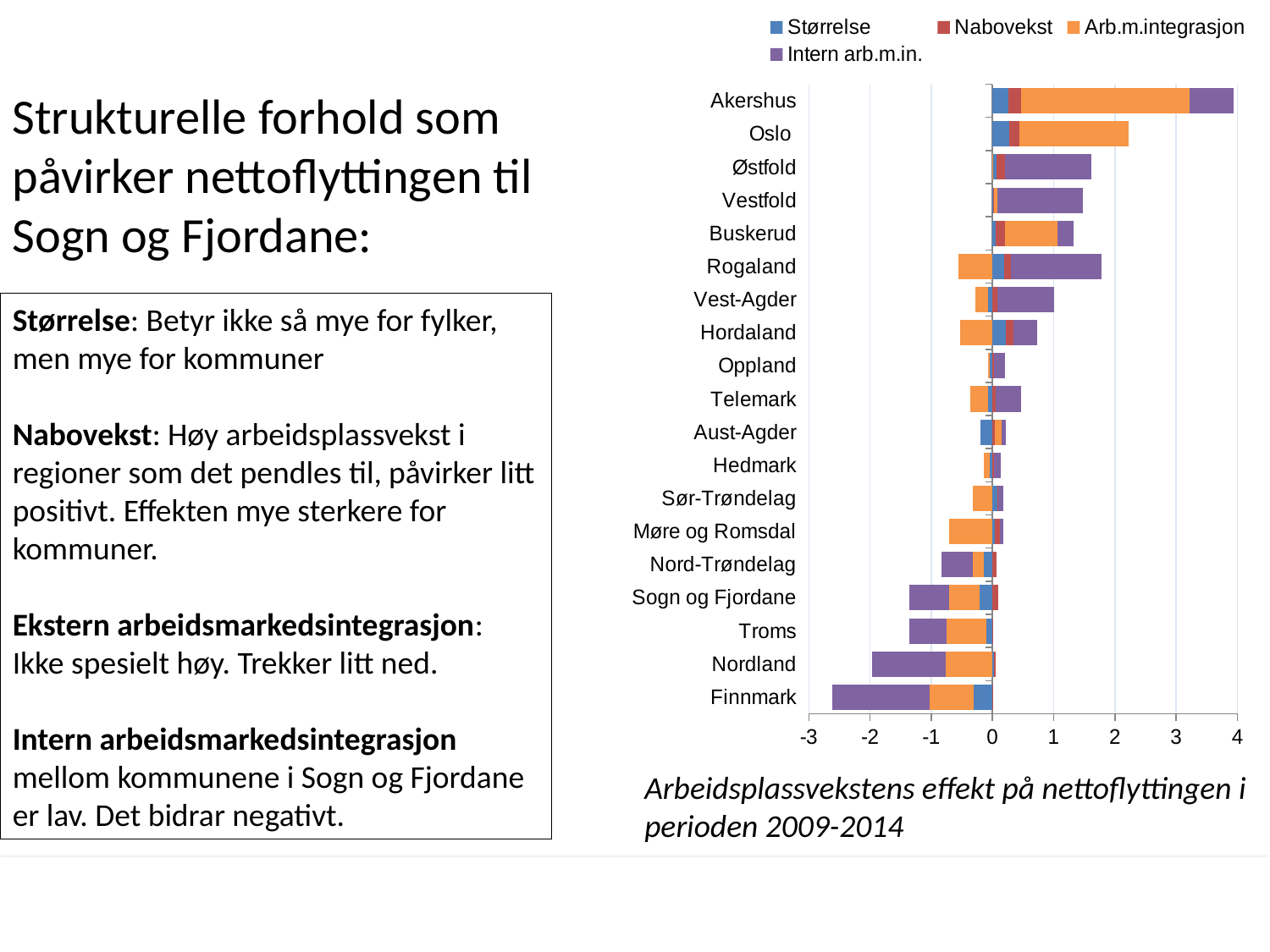
Which county's bar extends further in the positive direction, Akershus or Oslo? Akershus Do the bars generally increase or decrease going from the top of the chart (Akershus) to the bottom (Finnmark)? decrease Is the positive extent of the Akershus bar greater or less than 3? greater Which county has the bar extending furthest in the positive direction? Akershus How many counties (categories) are plotted on the y axis? 19 What kind of chart is shown on the slide? Stacked bar chart How many series does the legend list? 4 Is the negative extent of the Troms bar greater or less than -1? less Is the negative extent of the Finnmark bar greater or less than -2? less Which colour represents the series Arb.m.integrasjon in the legend? Orange Which county has the bar extending furthest in the negative direction? Finnmark